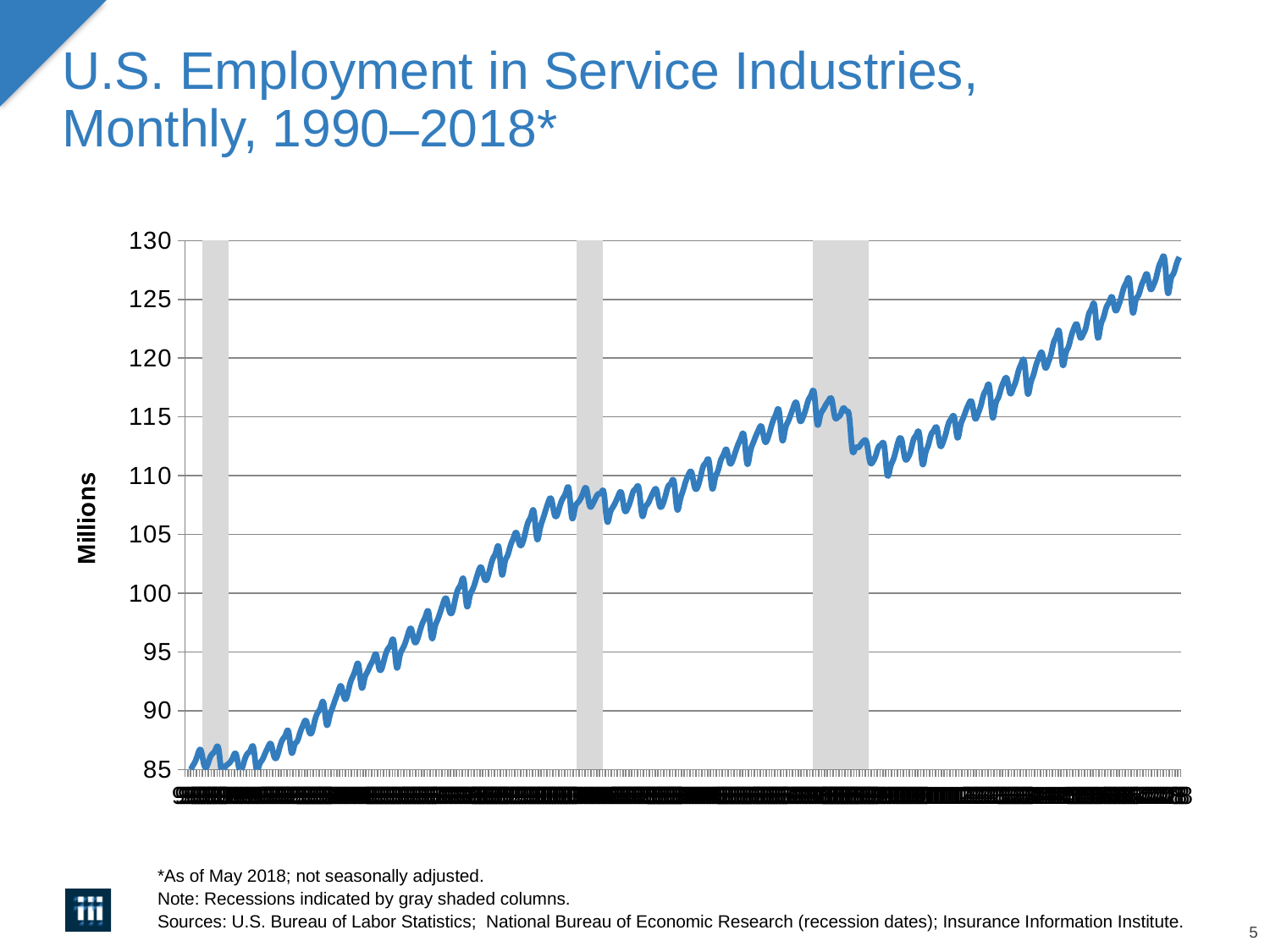
What is the lowest value shown on the vertical axis of the chart? 85 Which is larger, the value at the start of the series (1990) or the value at the end of the series (2018)? The value at the end (2018) Is the value at the start of the series (1990) greater or less than 90? less Overall, do the values rise or fall from 1990 to 2018 along the x axis? Rise What is the title of the chart on the slide? U.S. Employment in Service Industries, Monthly, 1990–2018* Is the value at the end of the series (2018) greater or less than 130? less What kind of chart is shown on the slide? Line chart Is the value at the end of the series (2018) greater or less than 125? greater Where along the x axis does the line reach its lowest value, at the beginning or at the end of the series? At the beginning Where along the x axis does the line reach its highest value, at the beginning or at the end of the series? At the end What is the label on the vertical axis of the chart? Millions